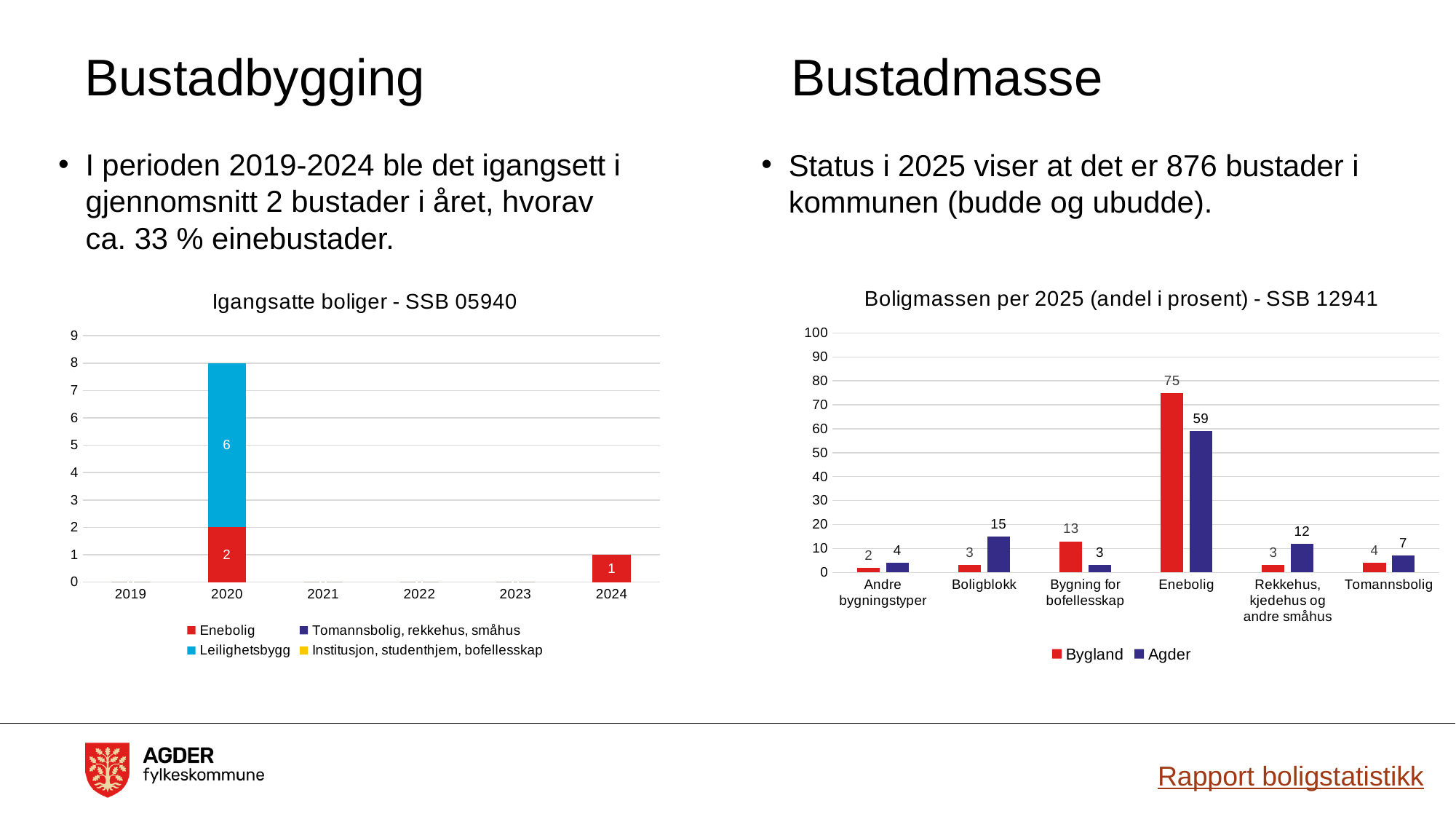
In the chart 'Boligmassen per 2025 (andel i prosent) - SSB 12941', what is the value for Agder for Boligblokk? 15 In the chart 'Igangsatte boliger - SSB 05940', what is the value for Leilighetsbygg in 2020? 6 In the chart 'Igangsatte boliger - SSB 05940', what is the value for Enebolig in 2024? 1 In the chart 'Boligmassen per 2025 (andel i prosent) - SSB 12941', which is larger for Bygning for bofellesskap, Bygland or Agder? Bygland In the chart 'Boligmassen per 2025 (andel i prosent) - SSB 12941', how many categories are shown on the x axis? 6 In the chart 'Igangsatte boliger - SSB 05940', what is the total of the stacked bar for 2020? 8 In the chart 'Igangsatte boliger - SSB 05940', how many series does the legend list? 4 In the chart 'Boligmassen per 2025 (andel i prosent) - SSB 12941', what is the value for Bygland for Enebolig? 75 In the chart 'Igangsatte boliger - SSB 05940', how many years are shown on the x axis? 6 What kind of chart is 'Boligmassen per 2025 (andel i prosent) - SSB 12941'? Bar chart In the chart 'Boligmassen per 2025 (andel i prosent) - SSB 12941', what is the difference between Bygland and Agder for Enebolig? 16 In the chart 'Boligmassen per 2025 (andel i prosent) - SSB 12941', which category has the highest value for Agder? Enebolig